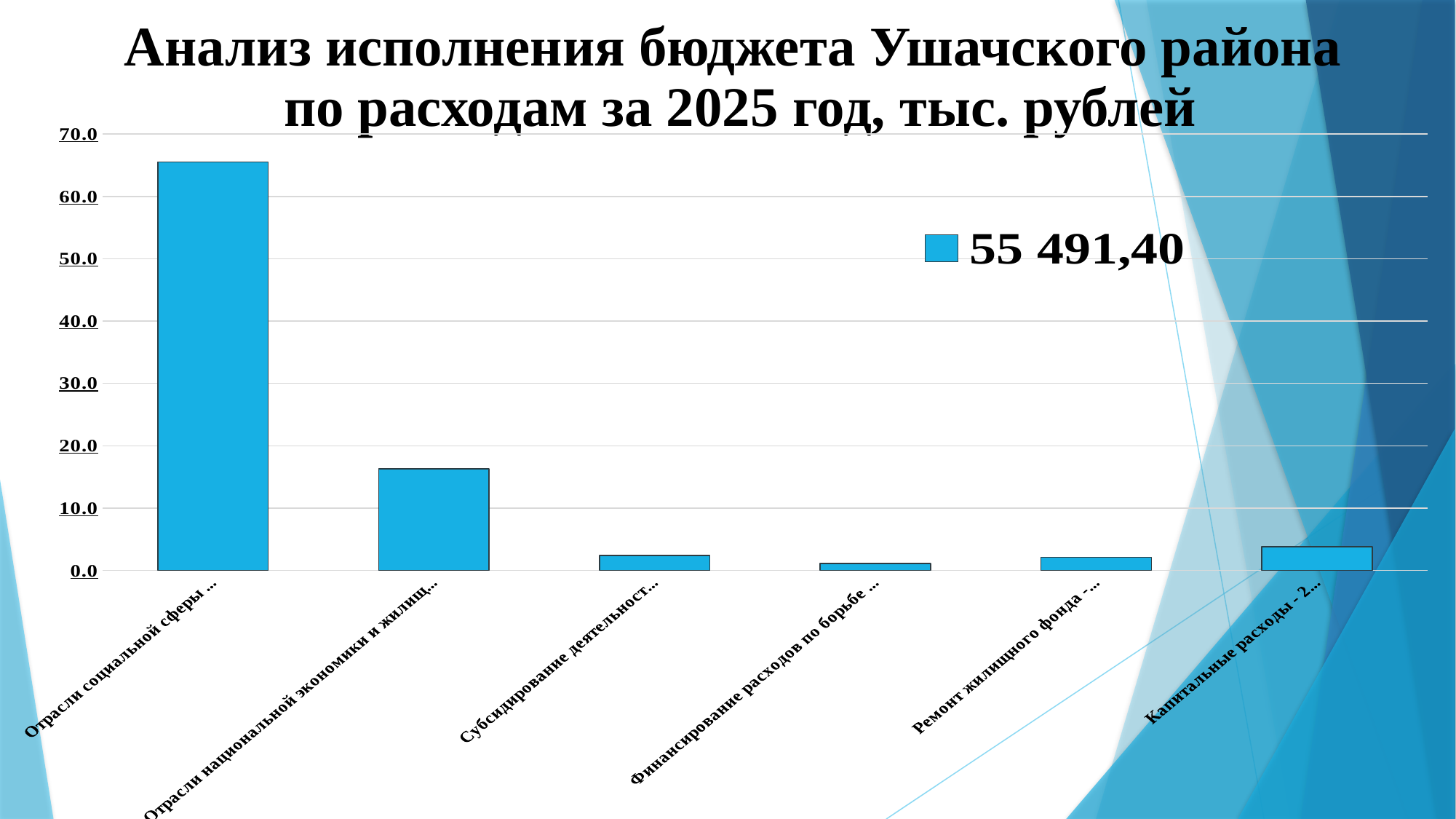
What kind of chart is shown on the slide? bar chart Which category has the highest bar? Отрасли социальной сферы Is the value for "Отрасли социальной сферы" greater or less than 60.0? greater What is the legend entry shown on the chart? 55 491,40 What is the title of the chart on the slide? Анализ исполнения бюджета Ушачского района по расходам за 2025 год, тыс. рублей How many categories (bars) does the chart show? 6 Is the value for "Отрасли национальной экономики и жилищ..." greater or less than 20.0? less Which is larger: the value for "Отрасли социальной сферы" or for "Отрасли национальной экономики и жилищ..."? Отрасли социальной сферы Is the value for "Отрасли национальной экономики и жилищ..." greater or less than 10.0? greater How many series does the legend list? 1 Which is larger: the value for "Капитальные расходы" or for "Финансирование расходов по борьбе ..."? Капитальные расходы